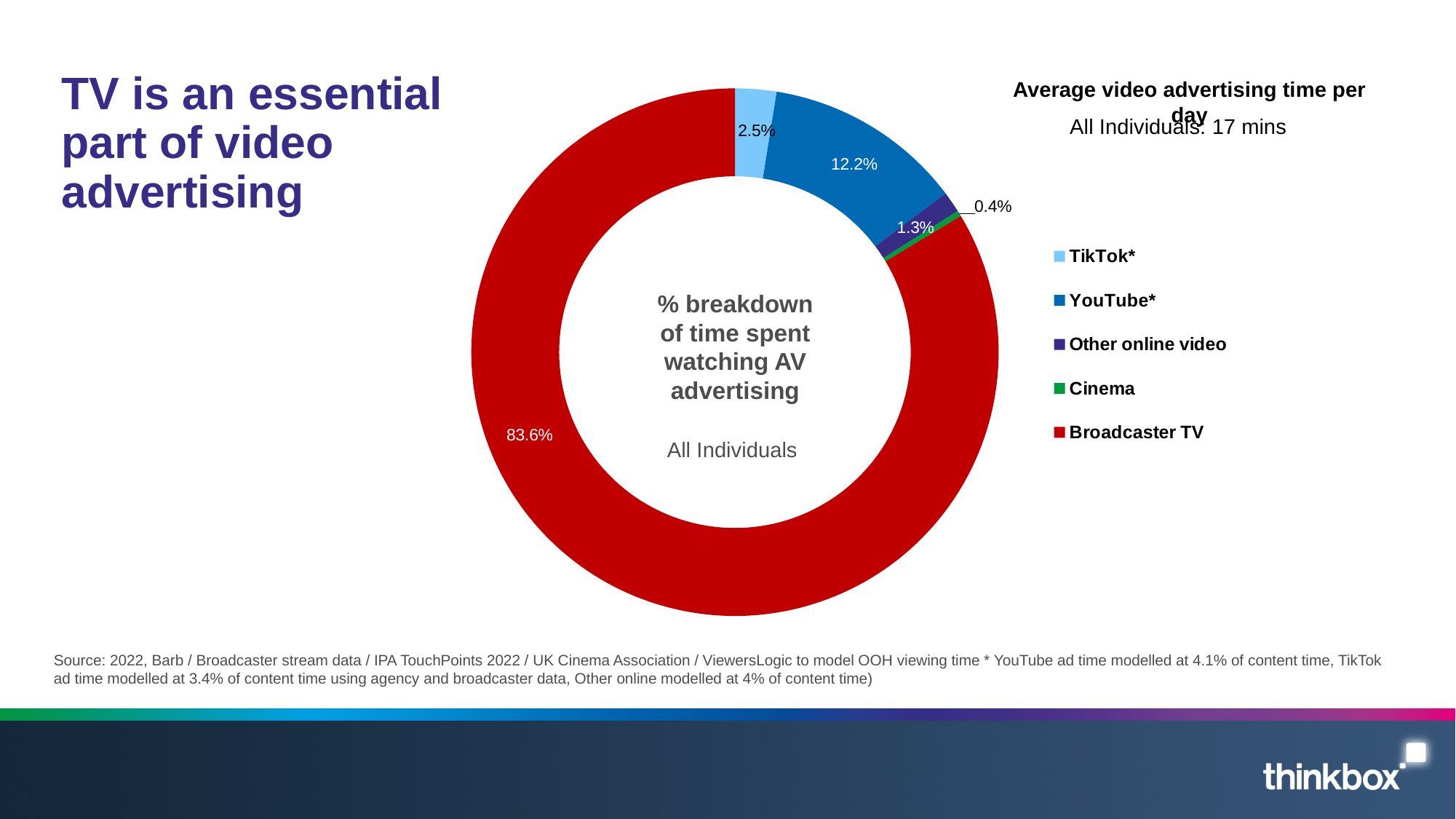
What percentage of AV advertising time is attributed to YouTube*? 12.2% What share of time spent watching AV advertising is attributed to Broadcaster TV? 83.6% What kind of chart is shown on the slide? Doughnut (pie) chart What percentage of AV advertising time is attributed to Other online video? 1.3% Which category has the largest share of AV advertising time? Broadcaster TV What is the difference in percentage points between the Broadcaster TV share and the YouTube* share? 71.4 What percentage of AV advertising time is attributed to TikTok*? 2.5% What percentage of AV advertising time is attributed to Cinema? 0.4% Which has a larger share of AV advertising time, TikTok* or Other online video? TikTok* How many categories does the legend list? 5 What is the average video advertising time per day for All Individuals stated on the slide? 17 mins Which category has the smallest share of AV advertising time? Cinema